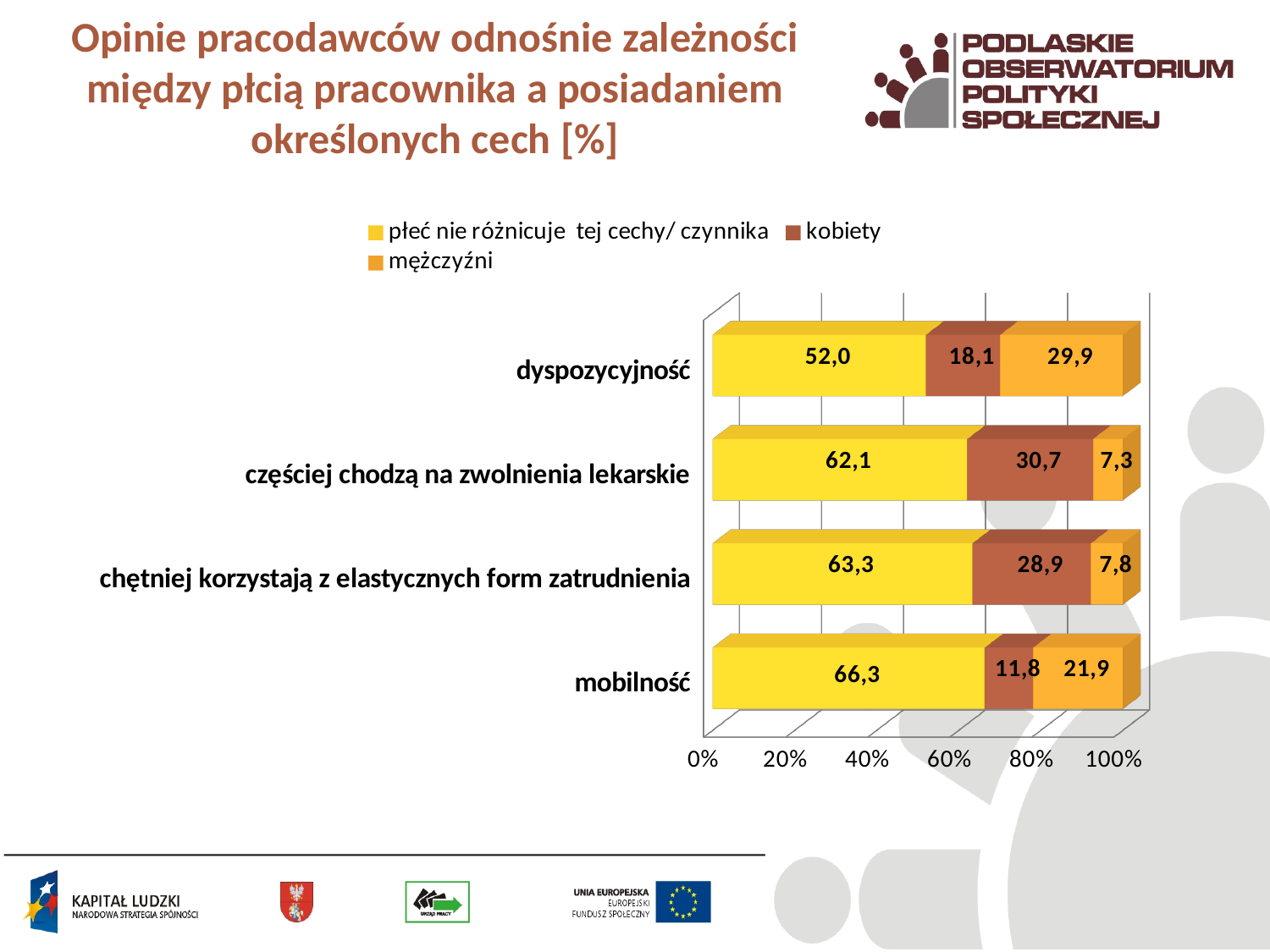
Which category has the highest value for 'płeć nie różnicuje tej cechy/ czynnika'? mobilność What kind of chart is shown on the slide? Stacked bar chart What is the value for 'płeć nie różnicuje tej cechy/ czynnika' in the 'częściej chodzą na zwolnienia lekarskie' category? 62,1 What is the value for 'mężczyźni' in the 'mobilność' category? 21,9 What is the total of the stacked bar for 'dyspozycyjność'? 100,0 Which colour represents the 'kobiety' series in the chart? Brown How many series does the legend list? 3 In the 'dyspozycyjność' category, which is larger: the value for 'kobiety' or for 'mężczyźni'? mężczyźni What is the difference between the 'kobiety' values for 'częściej chodzą na zwolnienia lekarskie' and 'mobilność'? 18,9 What is the value for 'kobiety' in the 'dyspozycyjność' category? 18,1 Which category has the lowest value for 'mężczyźni'? częściej chodzą na zwolnienia lekarskie How many categories are shown on the chart? 4